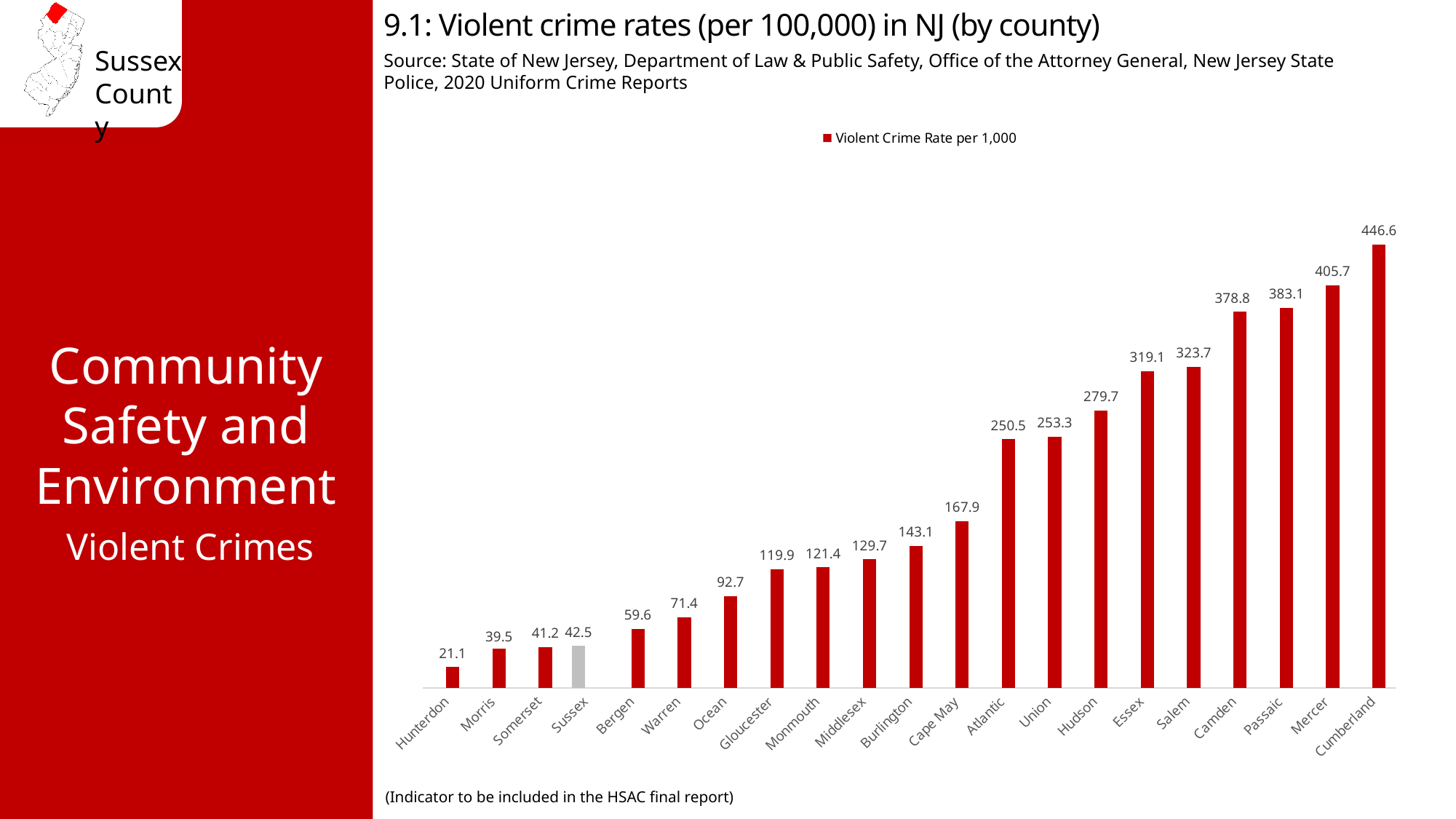
Which has a higher violent crime rate, Ocean or Warren? Ocean What is the difference between the violent crime rates of Cumberland and Hunterdon? 425.5 What is the violent crime rate shown for Sussex county? 42.5 How many series does the legend list? 1 Do the values rise or fall moving from left to right along the x axis? Rise What is the violent crime rate shown for Cape May? 167.9 What is the violent crime rate shown for Hudson? 279.7 What kind of chart is shown on the slide? Bar chart How many counties are shown on the chart? 21 What is the difference between the violent crime rates of Sussex and Hunterdon? 21.4 Which county has the lowest violent crime rate on the chart? Hunterdon Which county has the highest violent crime rate on the chart? Cumberland